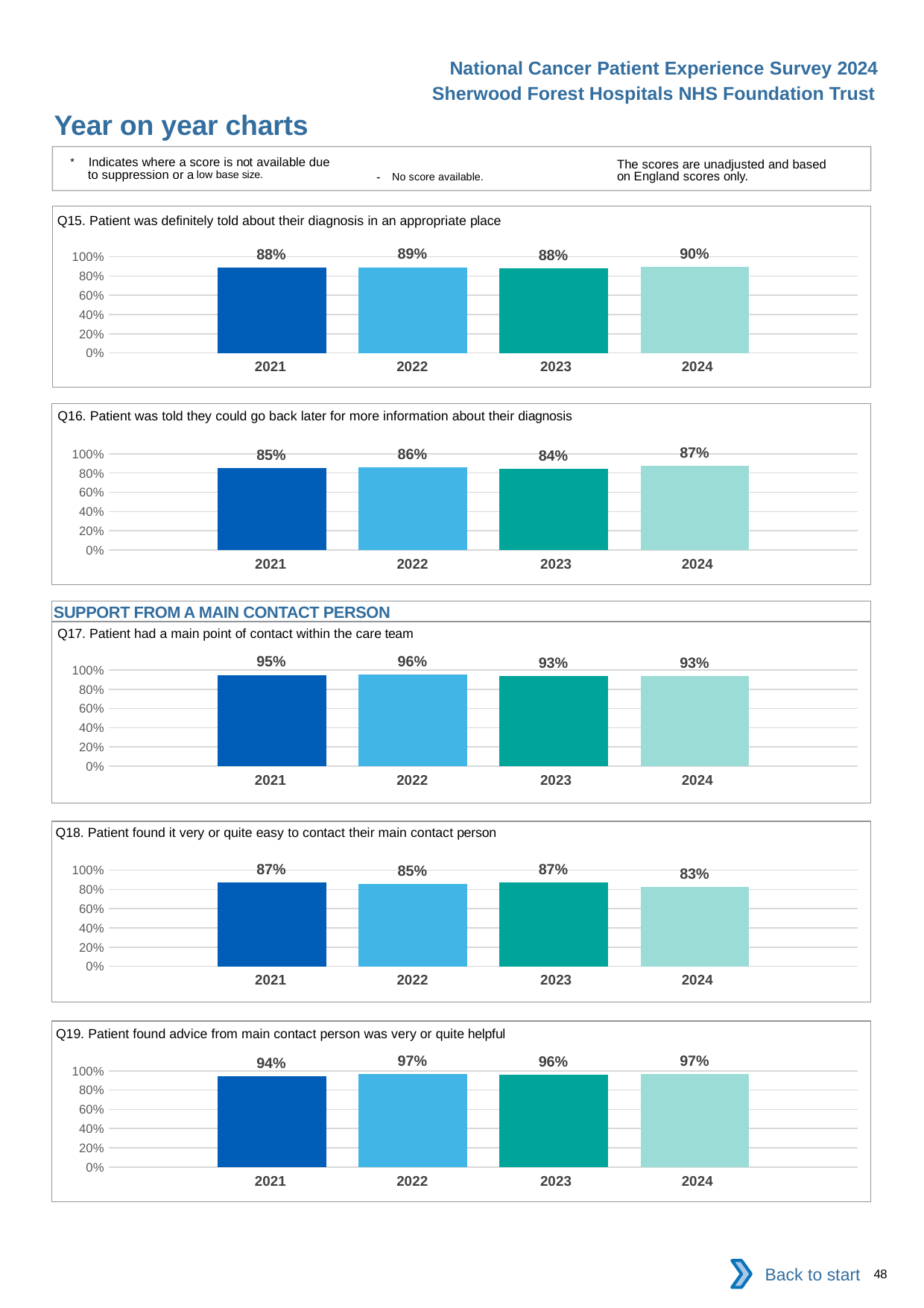
In the Q15 chart, is the value for 2022 greater or less than 80%? greater In the Q17 chart, which year has the highest value? 2022 In the Q16 chart, what is the difference between the 2024 value and the 2023 value? 3% In the Q15 chart, what is the value for 2024? 90% How many years are shown in the Q17 chart? 4 In the Q16 chart, which year has the lowest value? 2023 What is the section heading shown above the Q17 chart? SUPPORT FROM A MAIN CONTACT PERSON In the Q18 chart, is the value for 2021 or 2024 larger? 2021 What kind of chart is the Q19 chart? Bar chart In the Q19 chart, what is the value for 2021? 94% In the Q17 chart, what is the difference between the 2022 value and the 2024 value? 3% In the Q18 chart, which year has the lowest value? 2024